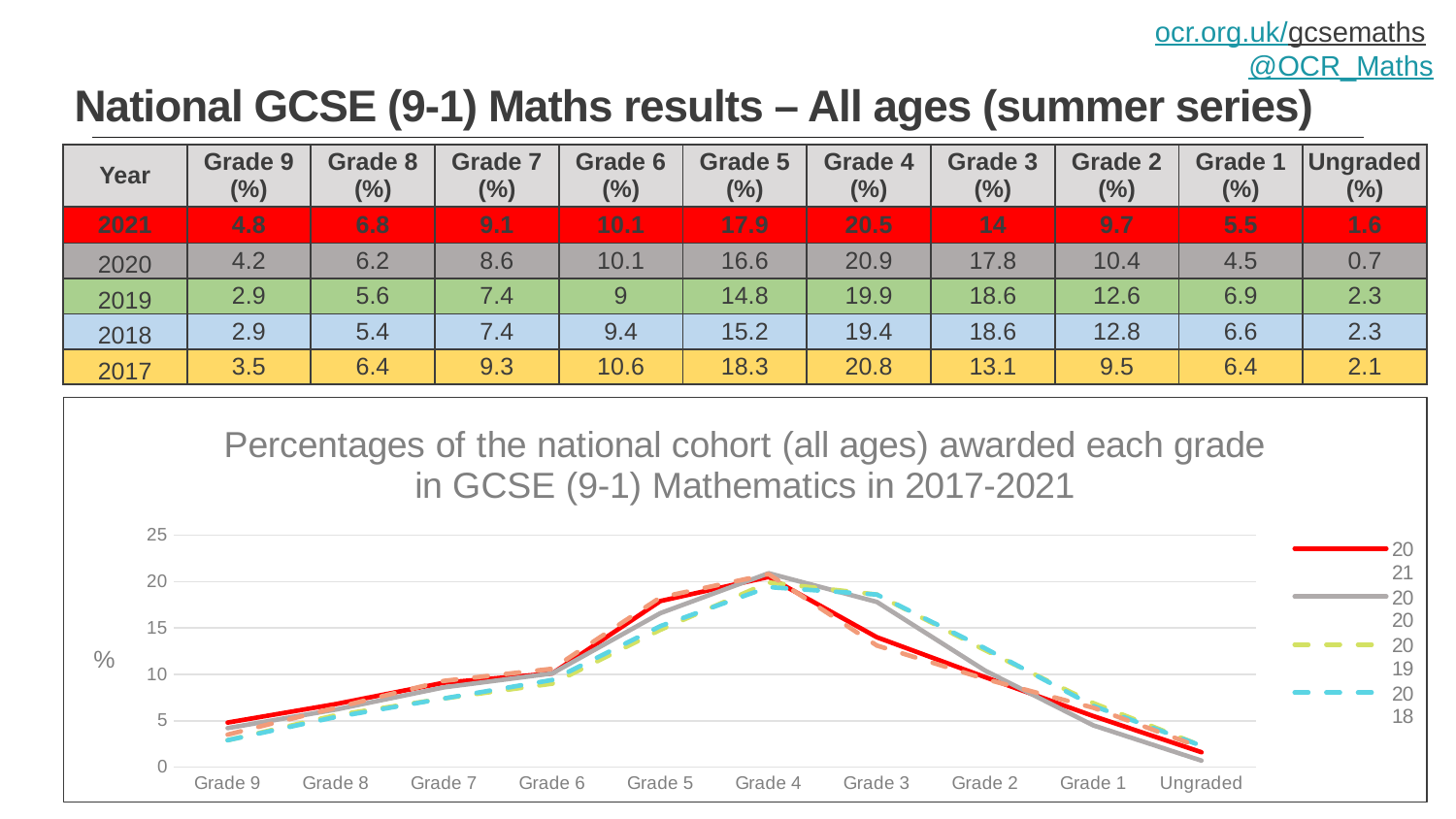
Is the value for Ungraded in 2021 greater or less than 5? less What is the difference between the Grade 3 percentage in 2020 and in 2021? 3.8 What percentage of the cohort was awarded Grade 4 in 2021? 20.5 What kind of chart is shown on the slide? line chart Which year has the larger Grade 9 percentage, 2021 or 2019? 2021 Is the value for Grade 5 in 2021 greater or less than 15? greater How many grade categories are shown along the x axis of the chart? 10 Do the values for the 2021 series rise or fall from Grade 9 to Grade 4? rise What percentage of the cohort was awarded Grade 5 in 2017? 18.3 What is the title of the chart? Percentages of the national cohort (all ages) awarded each grade in GCSE (9-1) Mathematics in 2017-2021 Which grade has the lowest percentage for the 2020 series? Ungraded Which grade has the highest percentage for the 2021 series? Grade 4